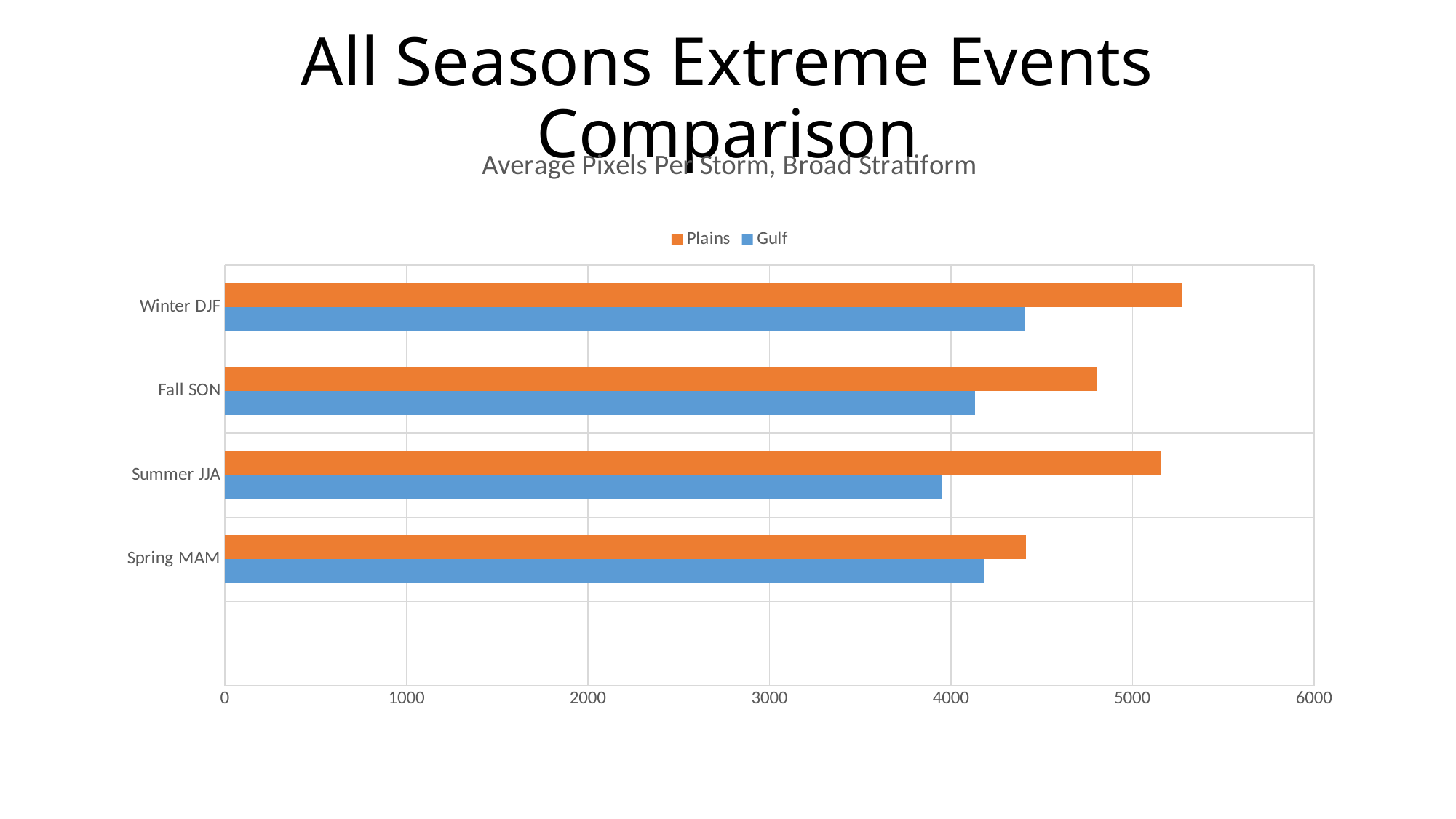
Which season has the highest Gulf value? Winter DJF Which season has the lowest Gulf value? Summer JJA Is the Plains value for Fall SON greater or less than 5000? less What kind of chart is shown on the slide? bar chart Is the Gulf value for Summer JJA greater or less than 4000? less For Summer JJA, which series has the larger value, Plains or Gulf? Plains What is the subtitle of the chart? Average Pixels Per Storm, Broad Stratiform How many seasons (categories) are plotted on the chart? 4 How many series does the legend list? 2 Which season has the lowest Plains value? Spring MAM For Winter DJF, which series has the larger value, Plains or Gulf? Plains Is the Plains value for Winter DJF greater or less than 5000? greater